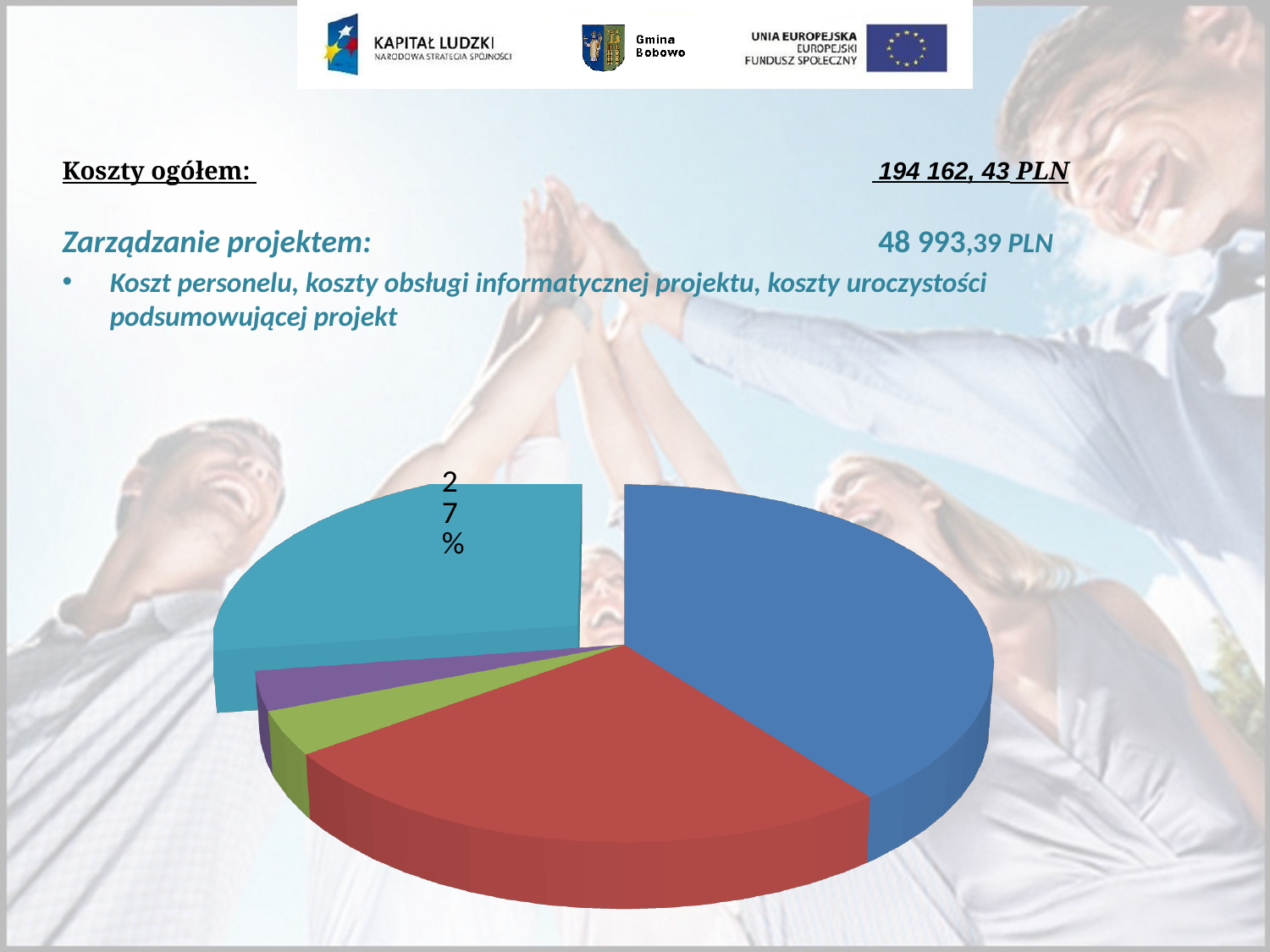
What percentage is printed on the light blue (teal) slice of the pie chart? 27% Does the pie chart include a legend? No Which is larger in the pie chart, the dark blue slice or the red slice? The dark blue slice Which is larger in the pie chart, the dark blue slice or the light blue slice labelled 27%? The dark blue slice How many slices does the pie chart have? 5 How many slices of the pie chart have a percentage label printed on them? 1 Which is larger in the pie chart, the red slice or the green slice? The red slice What kind of chart is shown on the slide? Pie chart Which slice of the pie chart is the largest? The dark blue slice